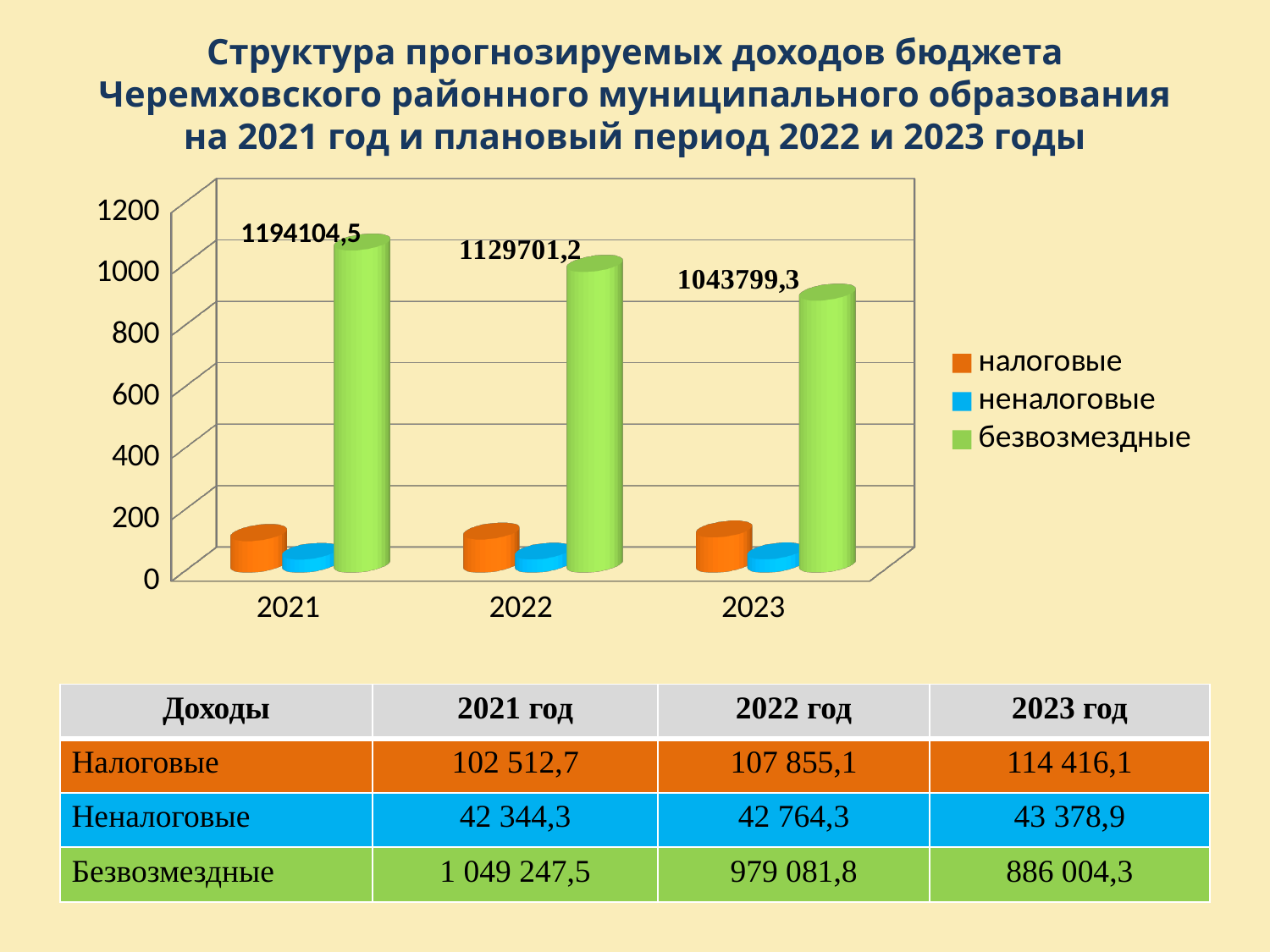
What kind of chart is shown on the slide? bar chart How many series does the chart legend list? 3 What is the value of безвозмездные for 2022 according to the table? 979 081,8 Which colour represents неналоговые in the legend? blue What is the value of налоговые for 2023 according to the table? 114 416,1 Do the безвозмездные bars rise or fall from 2021 to 2023? fall Which series has the highest bar in every year? безвозмездные Which series has the lowest bar in 2021? неналоговые How many years (categories) are shown on the x axis of the chart? 3 What is the total value labelled above the 2021 group of bars? 1194104,5 Is the безвозмездные bar for 2023 greater or less than 1000 on the axis? less What is the total value labelled above the 2023 group of bars? 1043799,3